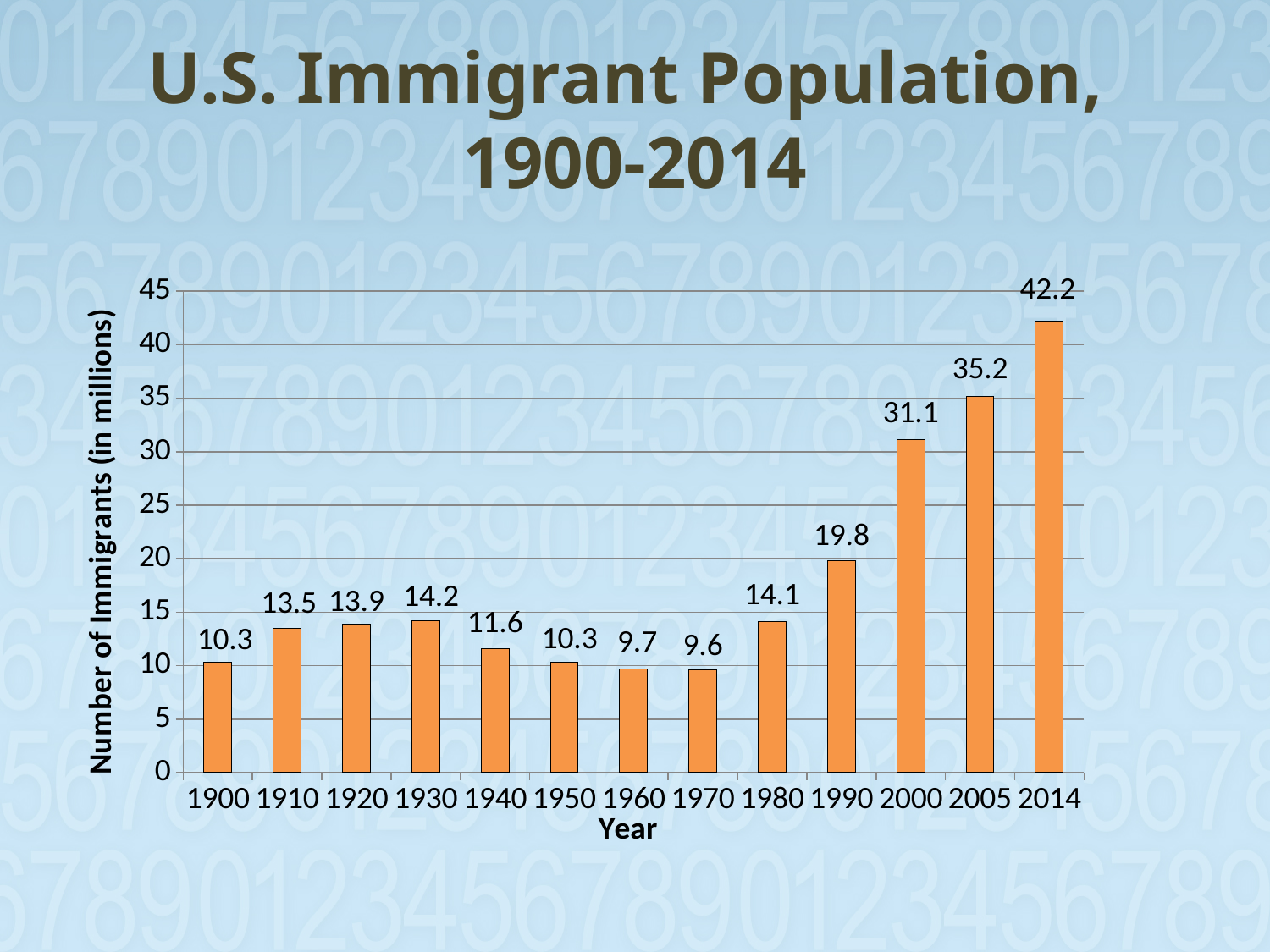
How many years are shown on the x axis? 13 What is the difference in millions between the values for 1930 and 1940? 2.6 Which year has a larger value, 1920 or 1980? 1980 What kind of chart is shown on the slide? Bar chart Is the value for 2000 greater or less than 30? greater What is the number of immigrants (in millions) for 1900? 10.3 What is the title of the chart? U.S. Immigrant Population, 1900-2014 Which year has the lowest number of immigrants? 1970 What is the number of immigrants (in millions) for 1990? 19.8 Which year has the highest number of immigrants? 2014 What is the number of immigrants (in millions) for 2005? 35.2 What is the difference in millions between the values for 2014 and 2000? 11.1